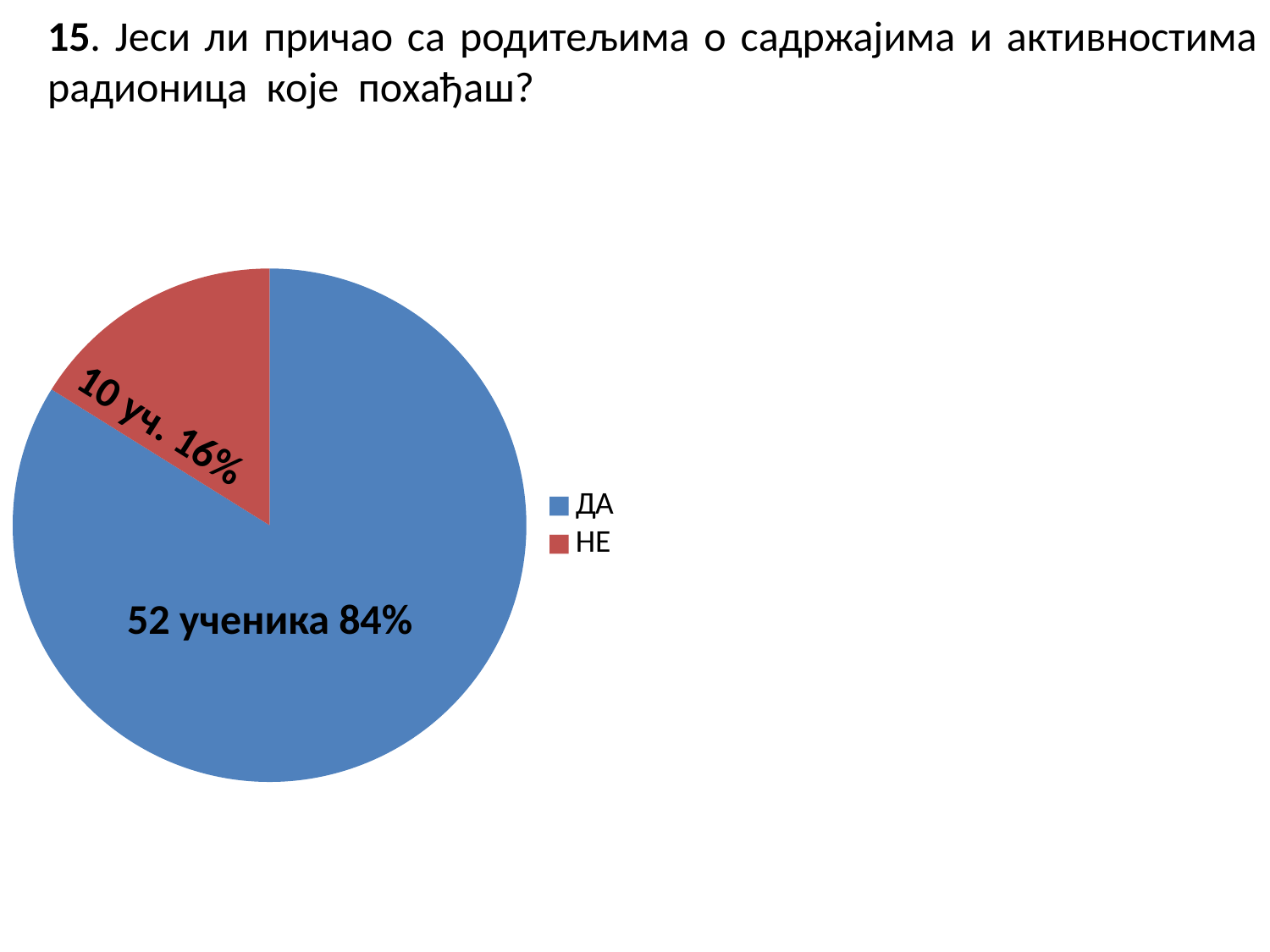
How many students answered НЕ? 10 What colour is the ДА slice? blue Which category has the smallest slice of the pie? НЕ What is the total number of students represented in the pie chart? 62 What percentage of the pie does the НЕ slice represent? 16% How many categories does the legend list? 2 What percentage of the pie does the ДА slice represent? 84% Which category has the largest slice of the pie? ДА How many students answered ДА? 52 How many more students answered ДА than НЕ? 42 Which is larger, the ДА slice or the НЕ slice? ДА What kind of chart is shown on the slide? pie chart